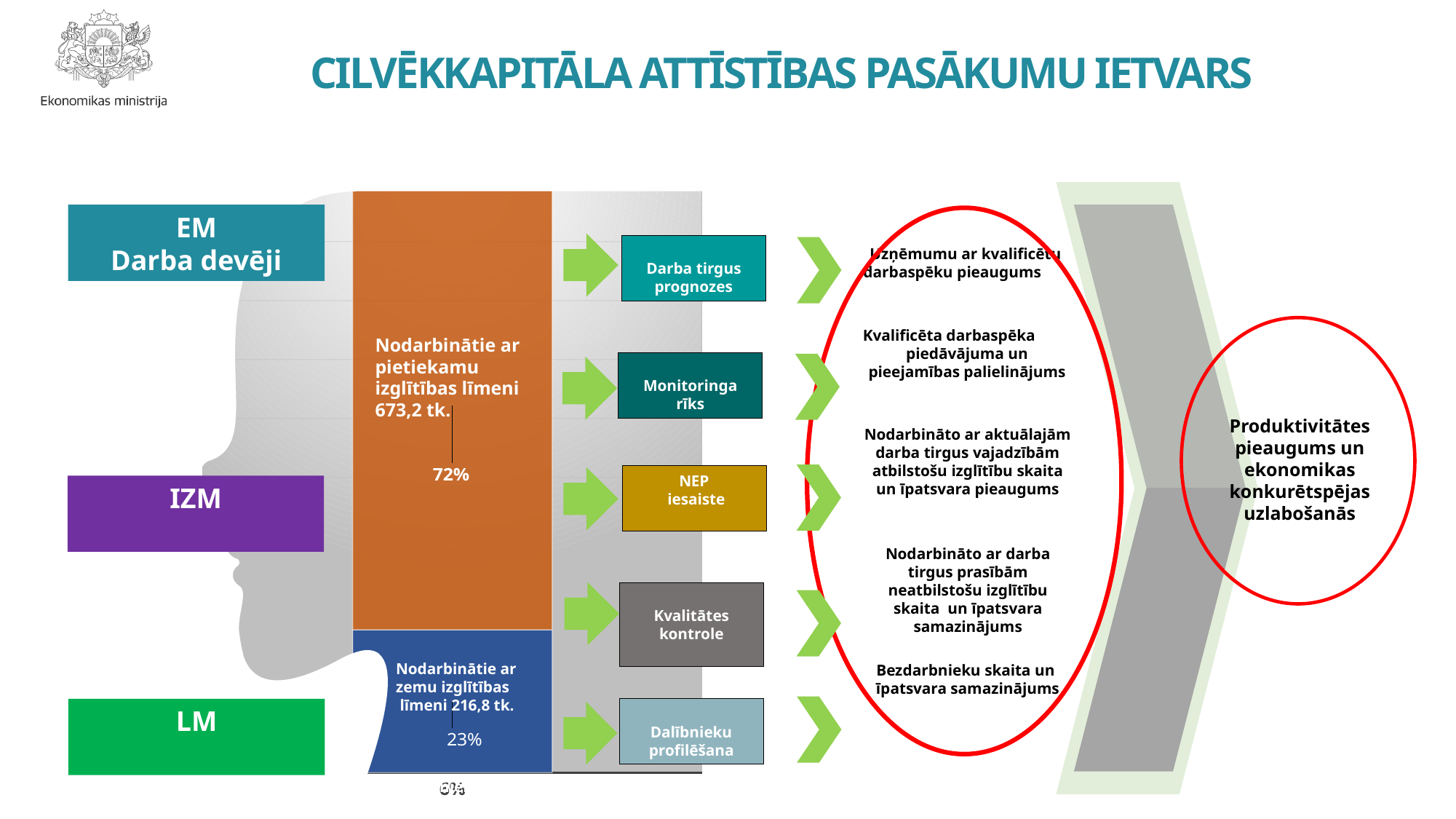
What is the difference in thousands between the 'pietiekamu izglītības līmeni' segment (673,2 tk.) and the 'zemu izglītības līmeni' segment (216,8 tk.)? 456,4 tk. What percentage is shown for the segment 'Nodarbinātie ar pietiekamu izglītības līmeni'? 72% By how many percentage points does the 72% segment exceed the 23% segment? 49% What value is shown for the segment 'Nodarbinātie ar zemu izglītības līmeni'? 216,8 tk. Which labelled segment of the stacked bar is the smallest? Nodarbinātie ar zemu izglītības līmeni What colour is the segment labelled 'Nodarbinātie ar pietiekamu izglītības līmeni'? Orange What value is shown for the segment 'Nodarbinātie ar pietiekamu izglītības līmeni'? 673,2 tk. What percentage is shown for the segment 'Nodarbinātie ar zemu izglītības līmeni'? 23% What kind of chart is shown on the left of the slide? Stacked bar chart What colour is the segment labelled 'Nodarbinātie ar zemu izglītības līmeni'? Blue Which is larger: the segment for employees with sufficient education level (pietiekamu) or with low education level (zemu)? Nodarbinātie ar pietiekamu izglītības līmeni Which labelled segment of the stacked bar is the largest? Nodarbinātie ar pietiekamu izglītības līmeni